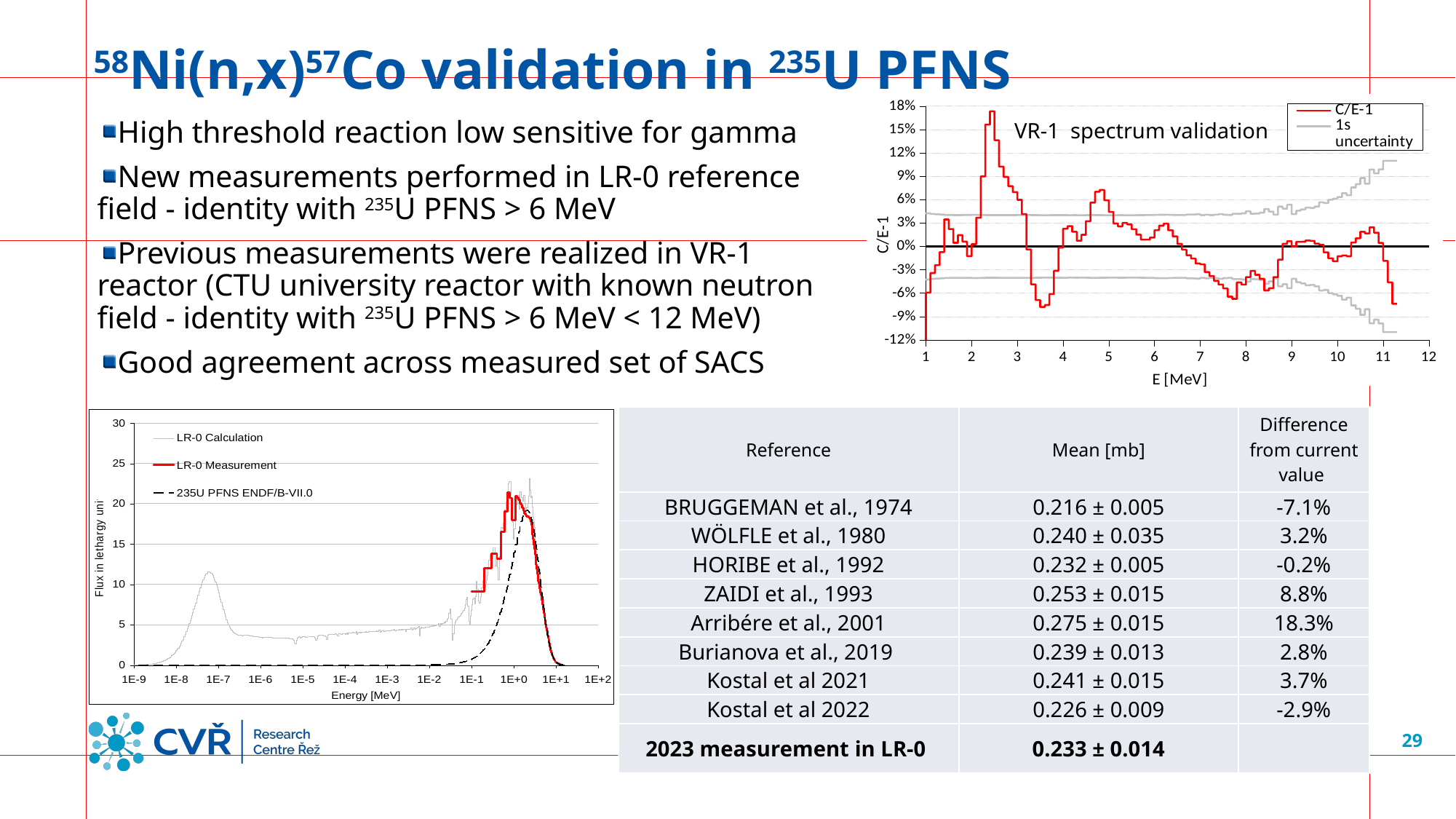
In the 'VR-1 spectrum validation' chart, is the peak value of the C/E-1 series near 2.5 MeV greater or less than 12%? greater In the bottom-left flux spectrum chart, which series is drawn as a dashed black line? 235U PFNS ENDF/B-VII.0 What kind of chart is the flux spectrum chart at the bottom left of the slide? line chart In the bottom-left flux spectrum chart, is the peak of the LR-0 Calculation curve near 1E-7 MeV greater or less than 15? less In the 'VR-1 spectrum validation' chart, does the upper 1s uncertainty band rise or fall as energy increases from 9 MeV to 11 MeV? rises How many series does the legend of the bottom-left flux spectrum chart list? 3 In the bottom-left flux spectrum chart, is the peak of the LR-0 Calculation curve near 1E-7 MeV greater or less than 10? greater What is the x-axis label of the 'VR-1 spectrum validation' chart? E [MeV] What kind of chart is the 'VR-1 spectrum validation' chart at the top right of the slide? line chart How many series does the legend of the 'VR-1 spectrum validation' chart list? 2